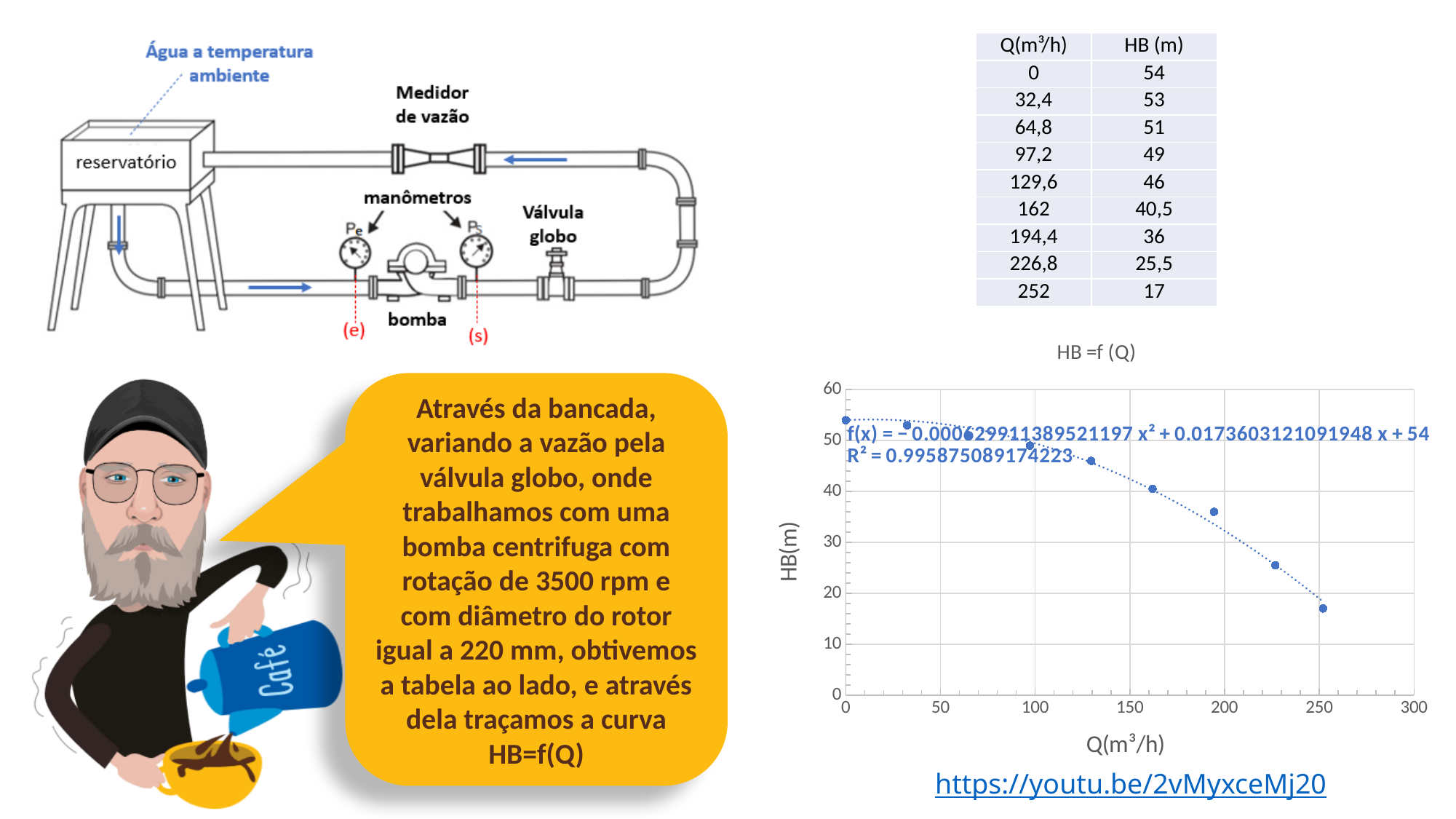
What is the difference between the HB value at Q = 0 and the HB value at Q = 252 m³/h? 37 In the chart "HB =f (Q)", do the HB values rise or fall as Q increases? fall What kind of chart is the chart titled "HB =f (Q)"? scatter chart How many data points are plotted in the chart "HB =f (Q)"? 9 According to the slide, what is HB (m) when Q is 252 m³/h? 17 What R² value is shown for the trendline in the chart "HB =f (Q)"? 0.995875089174223 According to the slide, what is HB (m) when Q is 0 m³/h? 54 In the chart "HB =f (Q)", at which value of Q is HB lowest? 252 In the chart "HB =f (Q)", is the HB value at Q = 226,8 greater or less than 20? greater In the chart "HB =f (Q)", at which value of Q is HB highest? 0 In the chart "HB =f (Q)", is the HB value at Q = 194,4 greater or less than 40? less According to the slide, what is HB (m) when Q is 162 m³/h? 40,5